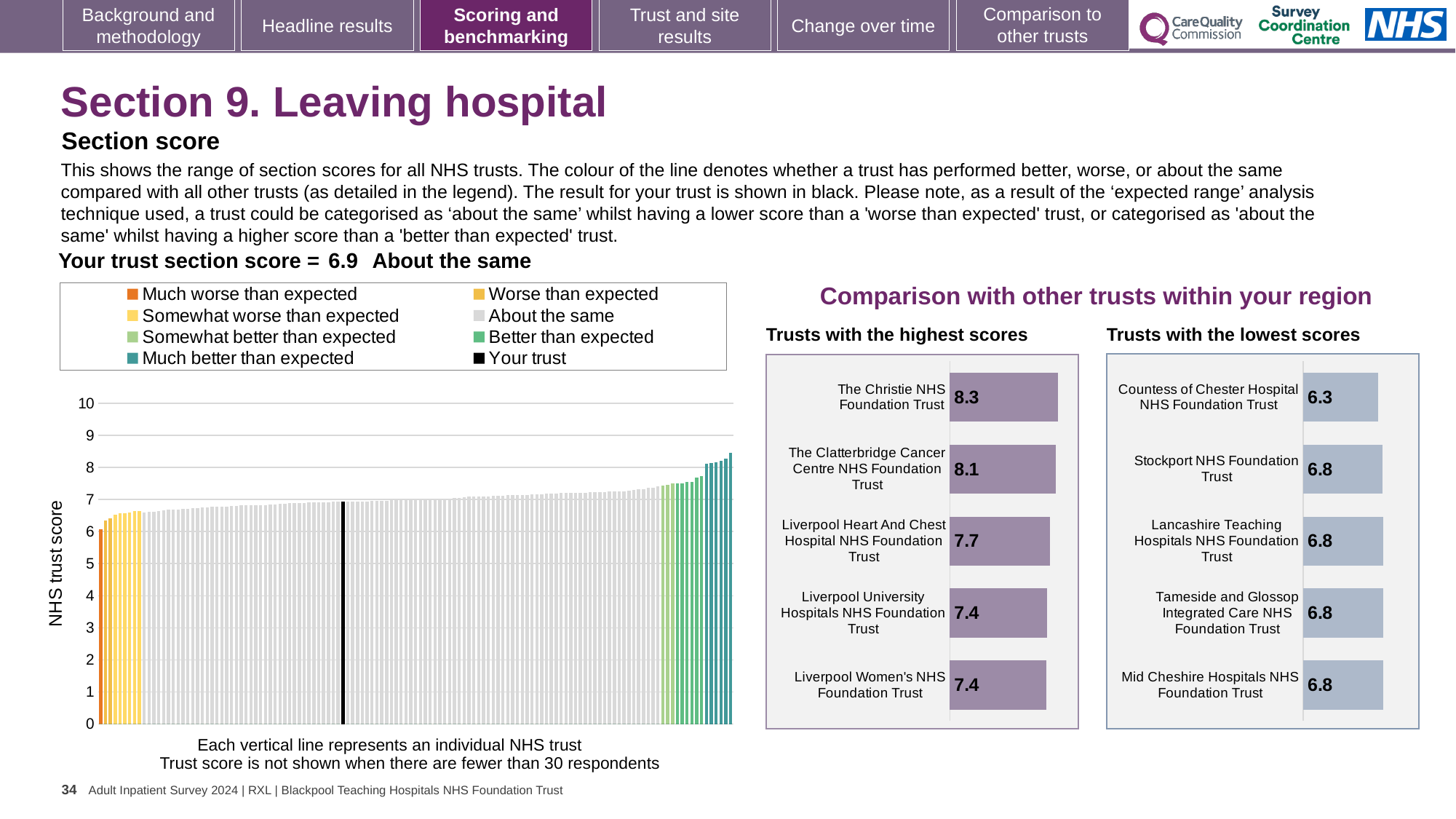
In the large chart of all NHS trusts on the left, what is the section score for your trust (the black line)? 6.9 In the 'Trusts with the highest scores' chart, what is the score for The Christie NHS Foundation Trust? 8.3 In the 'Trusts with the lowest scores' chart, which trust has the lowest score? Countess of Chester Hospital NHS Foundation Trust In the 'Trusts with the lowest scores' chart, what is the score for Countess of Chester Hospital NHS Foundation Trust? 6.3 In the 'Trusts with the highest scores' chart, which trust has the highest score? The Christie NHS Foundation Trust In the 'Trusts with the highest scores' chart, what is the difference between the scores of The Christie NHS Foundation Trust and The Clatterbridge Cancer Centre NHS Foundation Trust? 0.2 In the 'Trusts with the highest scores' chart, what is the score for Liverpool Heart And Chest Hospital NHS Foundation Trust? 7.7 In the 'Trusts with the lowest scores' chart, what is the difference between the scores of Stockport NHS Foundation Trust and Countess of Chester Hospital NHS Foundation Trust? 0.5 In the large chart of all NHS trusts on the left, is the value of the highest trust greater or less than 8? greater Which is larger: the score for The Clatterbridge Cancer Centre NHS Foundation Trust in the 'highest scores' chart or the score for Stockport NHS Foundation Trust in the 'lowest scores' chart? The Clatterbridge Cancer Centre NHS Foundation Trust In the 'Trusts with the highest scores' chart, how many trusts are shown? 5 In the 'Trusts with the lowest scores' chart, what is the score for Mid Cheshire Hospitals NHS Foundation Trust? 6.8